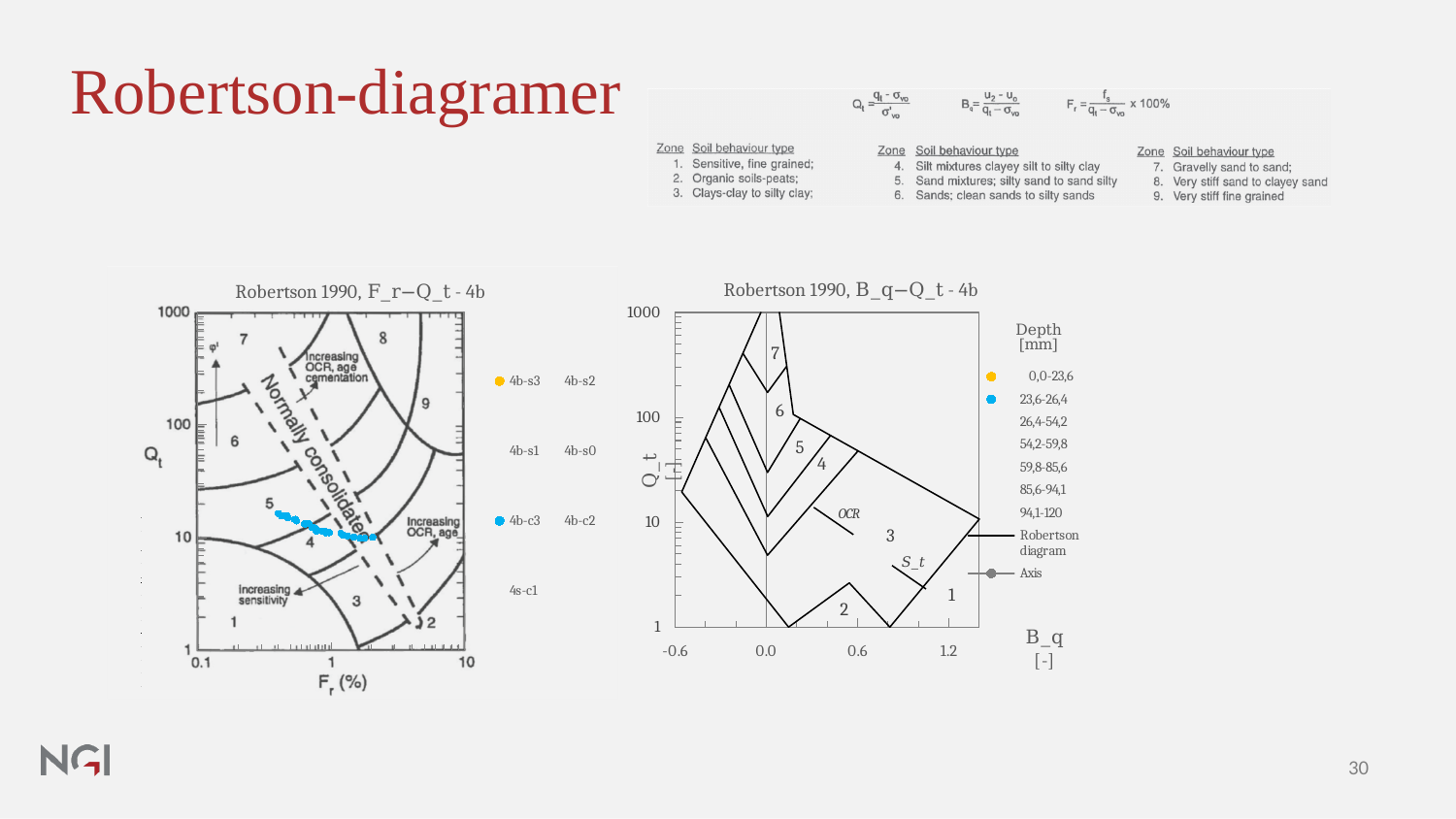
In the left chart (Robertson 1990, F_r–Q_t - 4b), are the plotted blue data points at F_r values greater or less than 10? less In the left chart (Robertson 1990, F_r–Q_t - 4b), are the plotted blue data points at Q_t values greater or less than 1? greater How many depth ranges are listed in the legend of the right chart (Robertson 1990, B_q–Q_t - 4b)? 7 How many series entries (4b-s3, 4b-s2, etc.) are listed in the legend of the left chart (Robertson 1990, F_r–Q_t - 4b)? 7 What is the highest tick value shown on the y axis of the right chart (Robertson 1990, B_q–Q_t - 4b)? 1000 What kind of chart is the left chart titled "Robertson 1990, F_r–Q_t - 4b"? scatter chart In the left chart (Robertson 1990, F_r–Q_t - 4b), are the plotted blue data points at Q_t values greater or less than 100? less What is the lowest tick value shown on the x axis of the right chart (Robertson 1990, B_q–Q_t - 4b)? -0.6 What kind of chart is the right chart titled "Robertson 1990, B_q–Q_t - 4b"? scatter chart What is the first depth range listed in the legend of the right chart (Robertson 1990, B_q–Q_t - 4b)? 0,0-23,6 What is the x-axis label of the left chart (Robertson 1990, F_r–Q_t - 4b)? F_r (%)